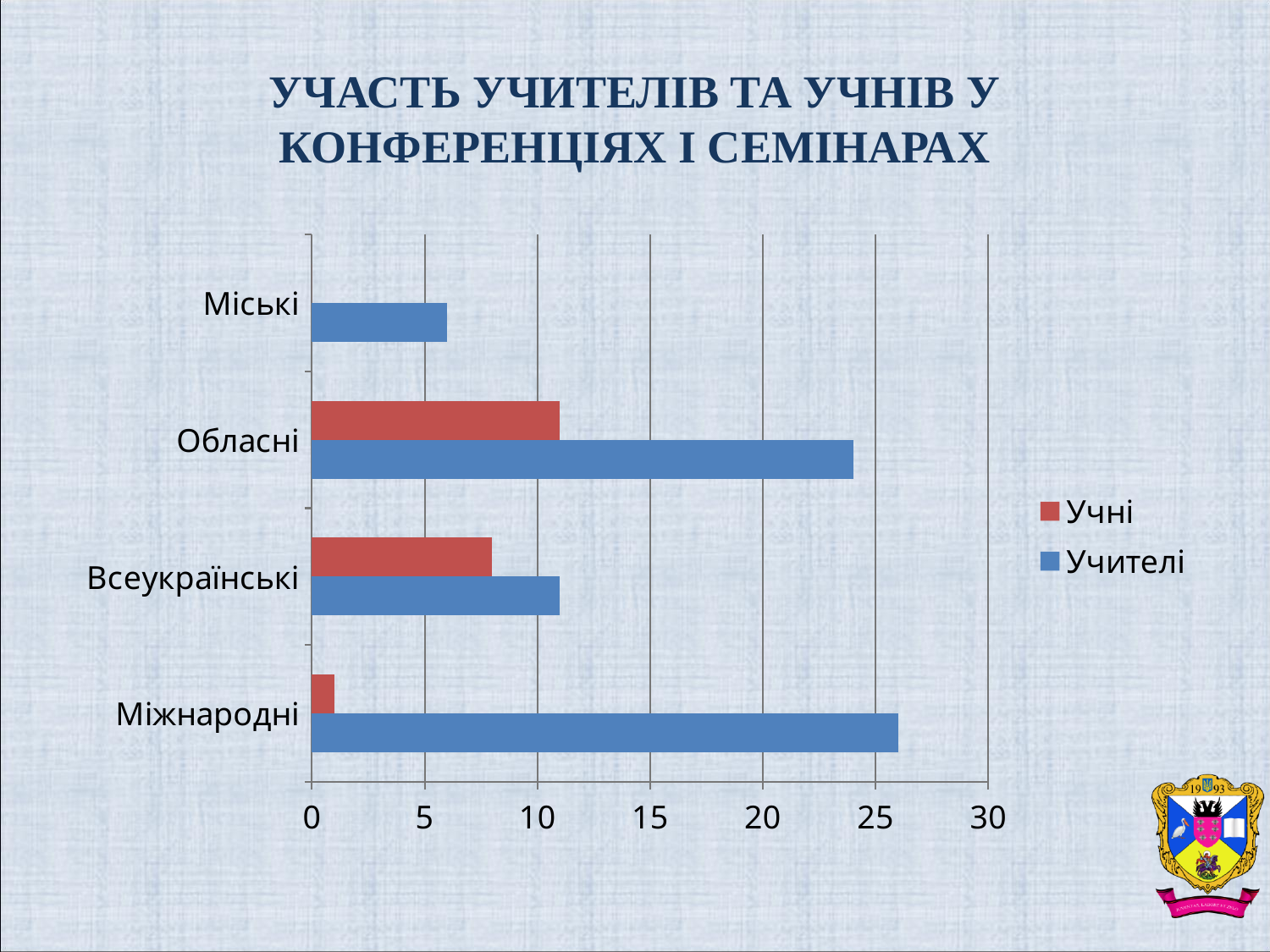
What kind of chart is shown on the slide? bar chart Which category has the highest value for Учні? Обласні Which category has the lowest value for Учні? Міські For Обласні, which is larger: Учні or Учителі? Учителі Is the value for Учні in Всеукраїнські greater or less than 10? less Is the value for Учителі in Обласні greater or less than 20? greater Is the value for Учителі in Міжнародні greater or less than 25? greater Which category has the lowest value for Учителі? Міські How many categories are shown on the vertical axis? 4 How many series does the legend list? 2 Which category has the highest value for Учителі? Міжнародні What colour are the bars for the Учні series? red